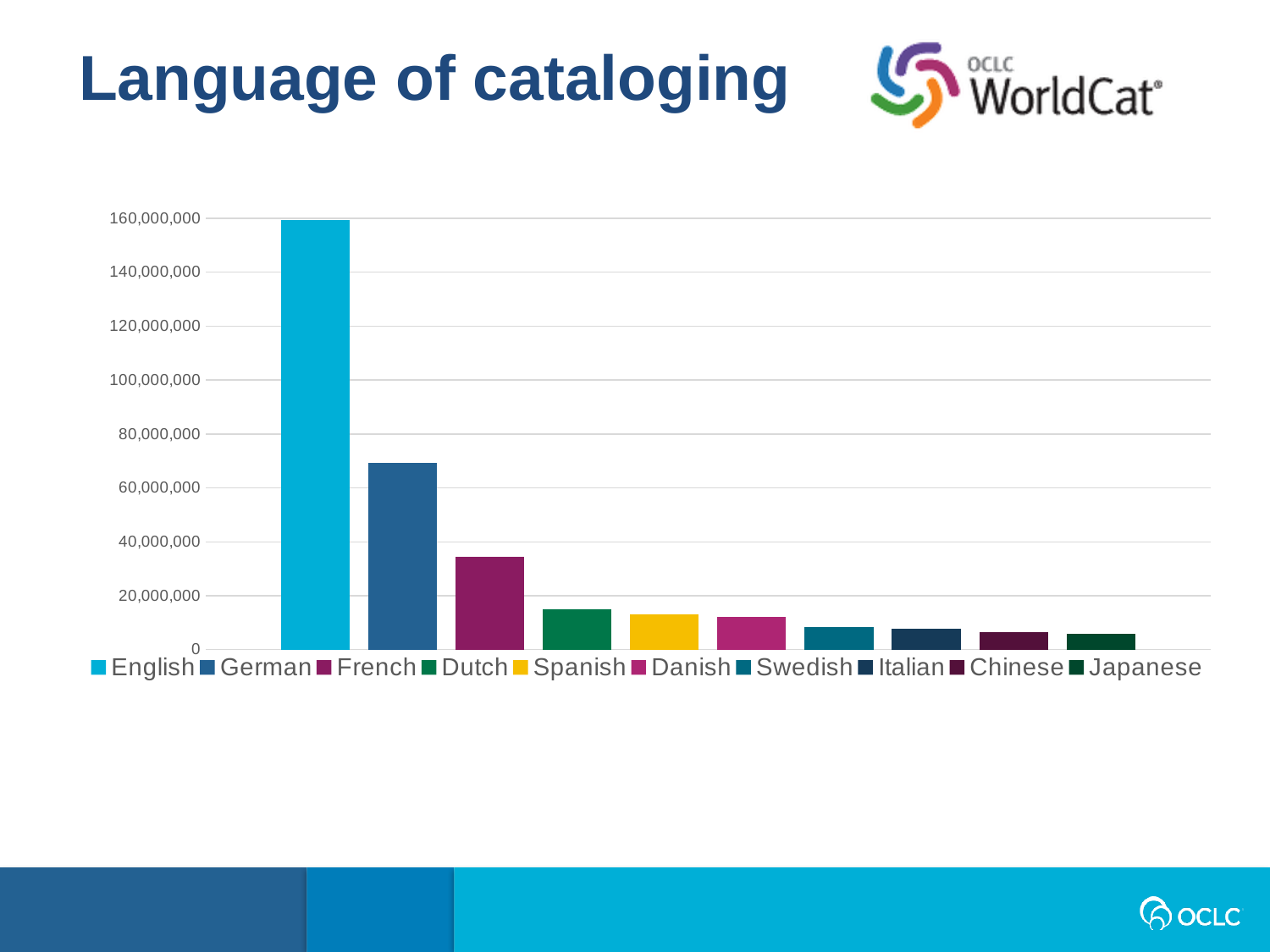
Do the values rise or fall moving from left to right across the languages? fall Is the value for English greater or less than 140,000,000? greater What kind of chart is shown on the slide? bar chart Is the value for German greater or less than 60,000,000? greater Is the value for French greater or less than 40,000,000? less Which language has the highest value in the chart? English How many languages are plotted in the chart? 10 Which has a larger value, German or French? German What is the title of the slide containing the chart? Language of cataloging How many entries does the legend list? 10